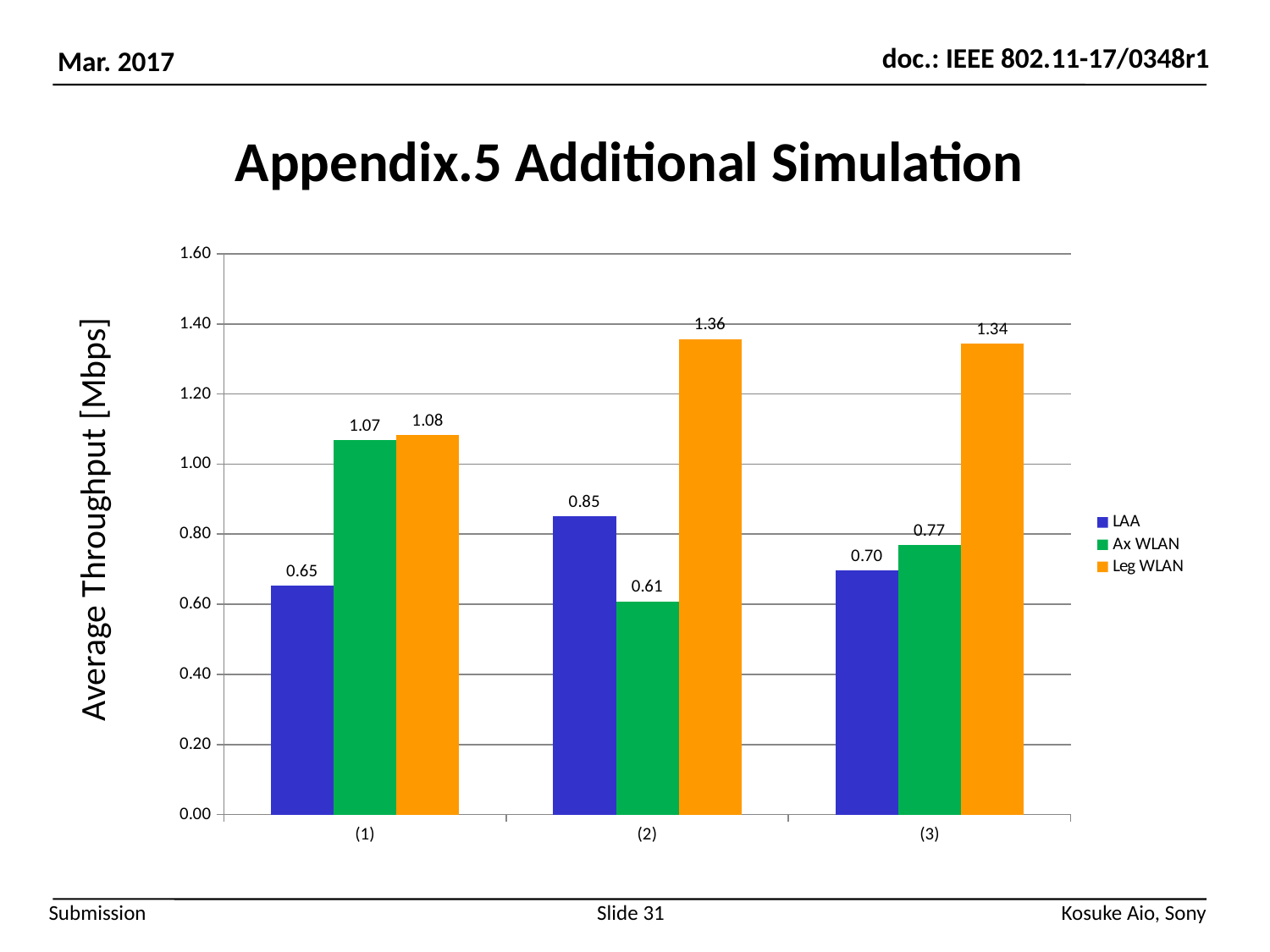
Which is larger in scenario (2): the LAA value or the Ax WLAN value? LAA How many scenario categories are shown on the x axis? 3 What is the difference between the Leg WLAN and LAA values in scenario (3)? 0.64 Which series has the highest average throughput in scenario (2)? Leg WLAN What is the average throughput for Ax WLAN in scenario (3)? 0.77 What is the average throughput for Leg WLAN in scenario (2)? 1.36 What is the label of the y axis? Average Throughput [Mbps] Which series has the lowest average throughput in scenario (1)? LAA What kind of chart is shown on the slide? Bar chart How many series does the legend list? 3 Is the Leg WLAN value in scenario (1) greater or less than 1.00? greater What is the average throughput for LAA in scenario (1)? 0.65